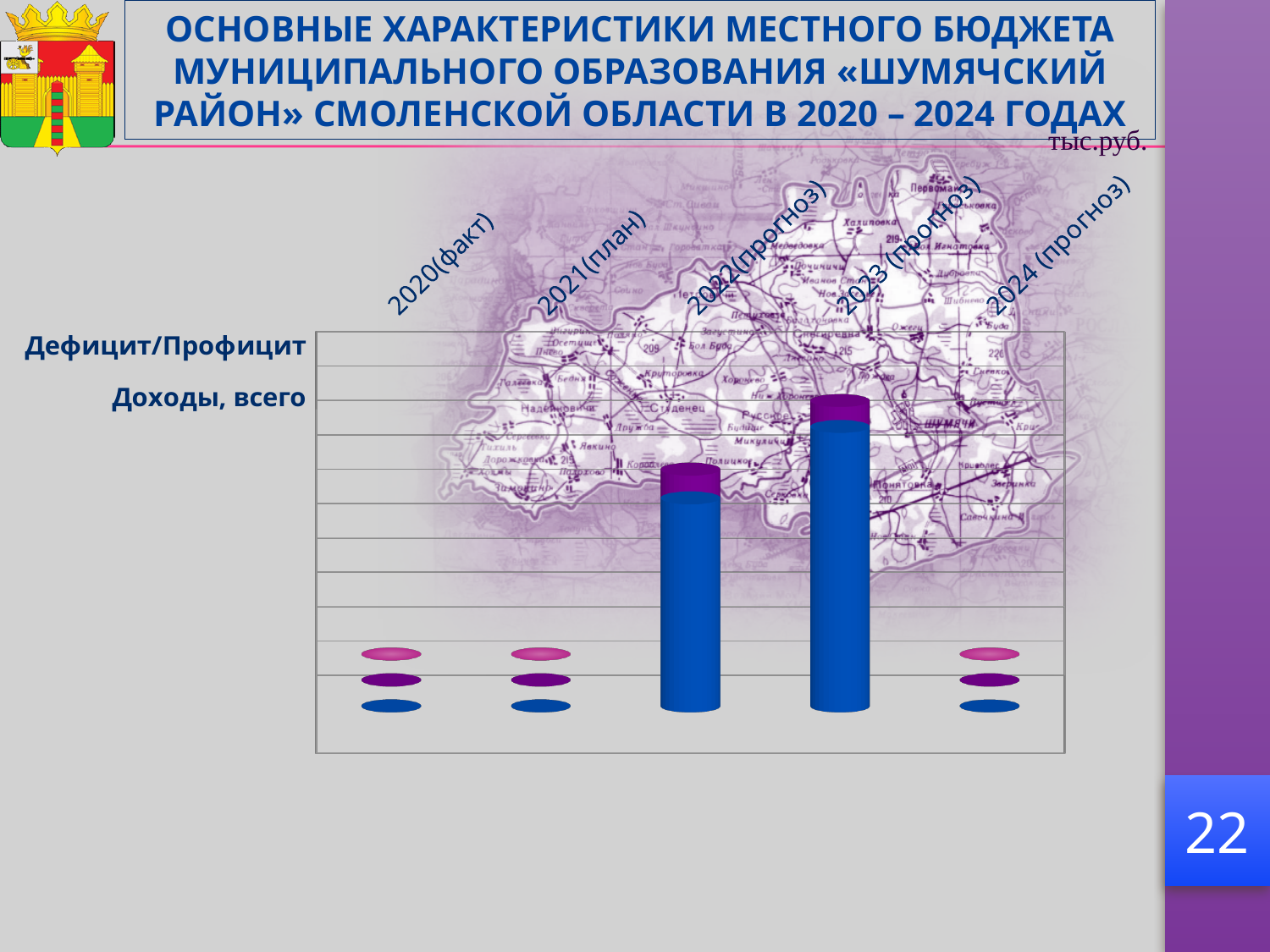
What kind of chart is shown on the slide? bar chart Which year category has the tallest bar in the chart? 2023 (прогноз) What is the label of the first (leftmost) category on the x axis of the chart? 2020(факт) Which two year categories have visible bars rising above the base of the chart? 2022(прогноз) and 2023 (прогноз) How many year categories are shown along the x axis of the chart? 5 What unit of measurement is indicated for the chart values? тыс.руб. Which is larger in the chart, the bar for 2022(прогноз) or the bar for 2023 (прогноз)? 2023 (прогноз)